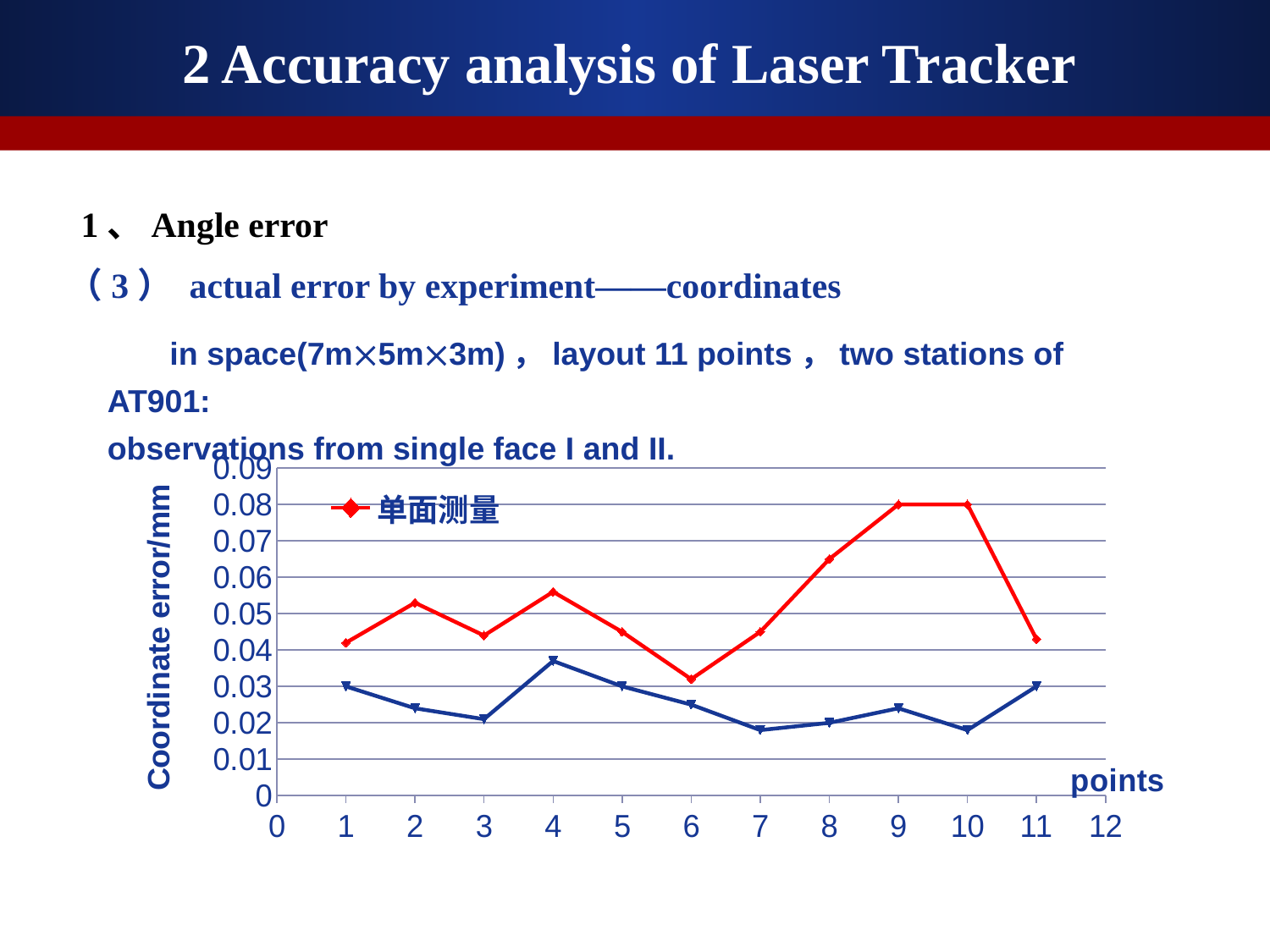
What is the title of the vertical axis of the chart? Coordinate error/mm Is the value of the red line (单面测量) at point 6 greater or less than 0.03? greater How many data points does each line on the chart have? 11 What kind of chart is shown on the slide? line chart At which point does the blue line reach its highest value? 4 Does the red line (单面测量) rise or fall from point 6 to point 9? rise At which point does the red line (单面测量) reach its lowest value? 6 Is the value of the blue line at point 7 greater or less than 0.02? less Is the value of the red line (单面测量) at point 8 greater or less than 0.06? greater How many series does the chart legend list? 1 What is the title of the horizontal axis of the chart? points At point 4, which line has the higher value, the red line (单面测量) or the blue line? the red line (单面测量)